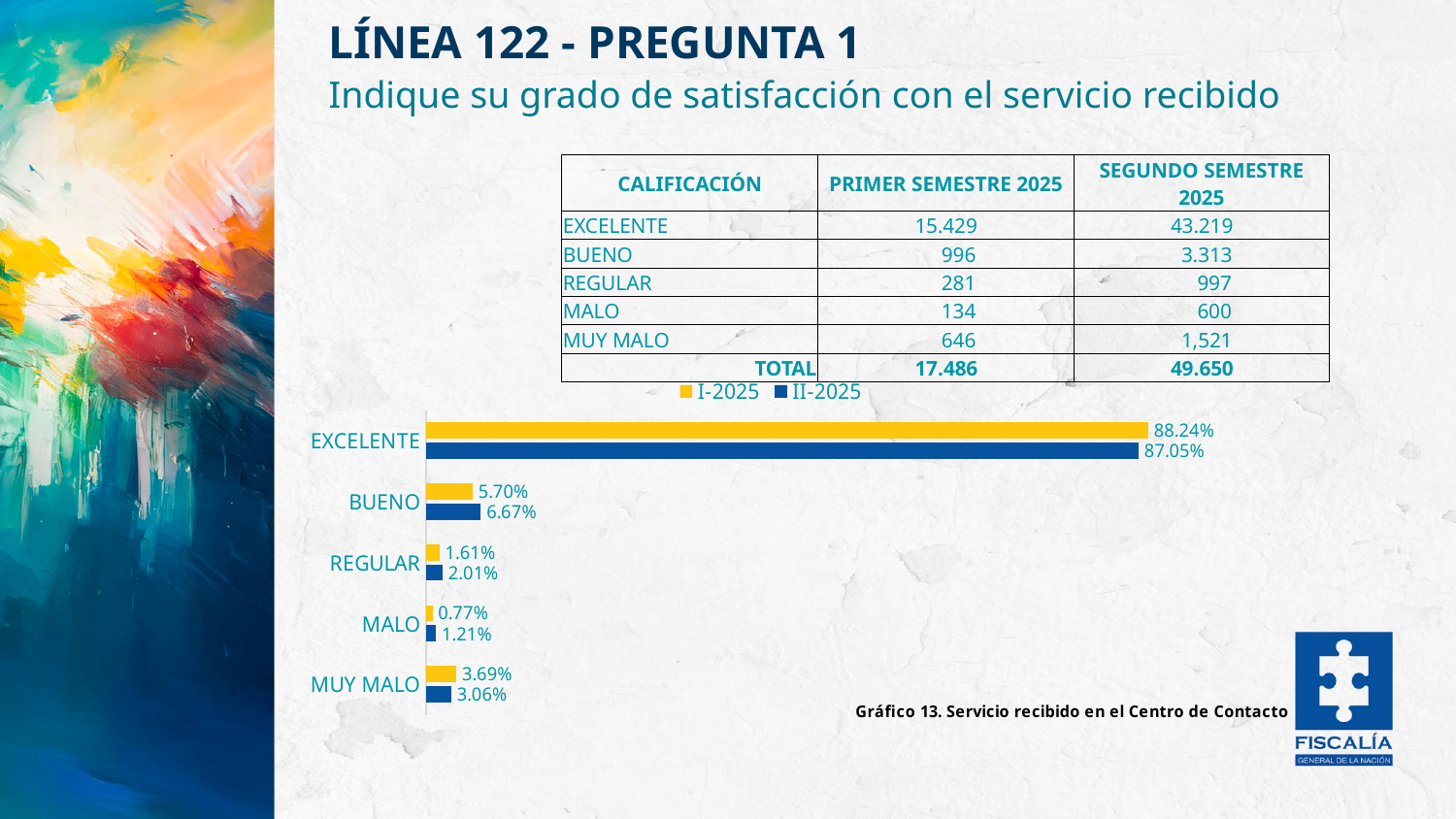
What is the II-2025 value for MALO in the bar chart? 1.21% For REGULAR, which series has the larger value in the bar chart, I-2025 or II-2025? II-2025 Which category has the lowest I-2025 value in the bar chart? MALO How many series does the legend of the bar chart list? 2 Which category has the highest II-2025 value in the bar chart? EXCELENTE What type of chart is shown on the slide? Bar chart What is the II-2025 value for BUENO in the bar chart? 6.67% Which colour represents the I-2025 series in the bar chart? Yellow How many categories are shown in the bar chart? 5 What is the I-2025 value for MUY MALO in the bar chart? 3.69% What is the I-2025 value for EXCELENTE in the bar chart? 88.24% What is the difference between the I-2025 and II-2025 values for EXCELENTE in the bar chart? 1.19 percentage points